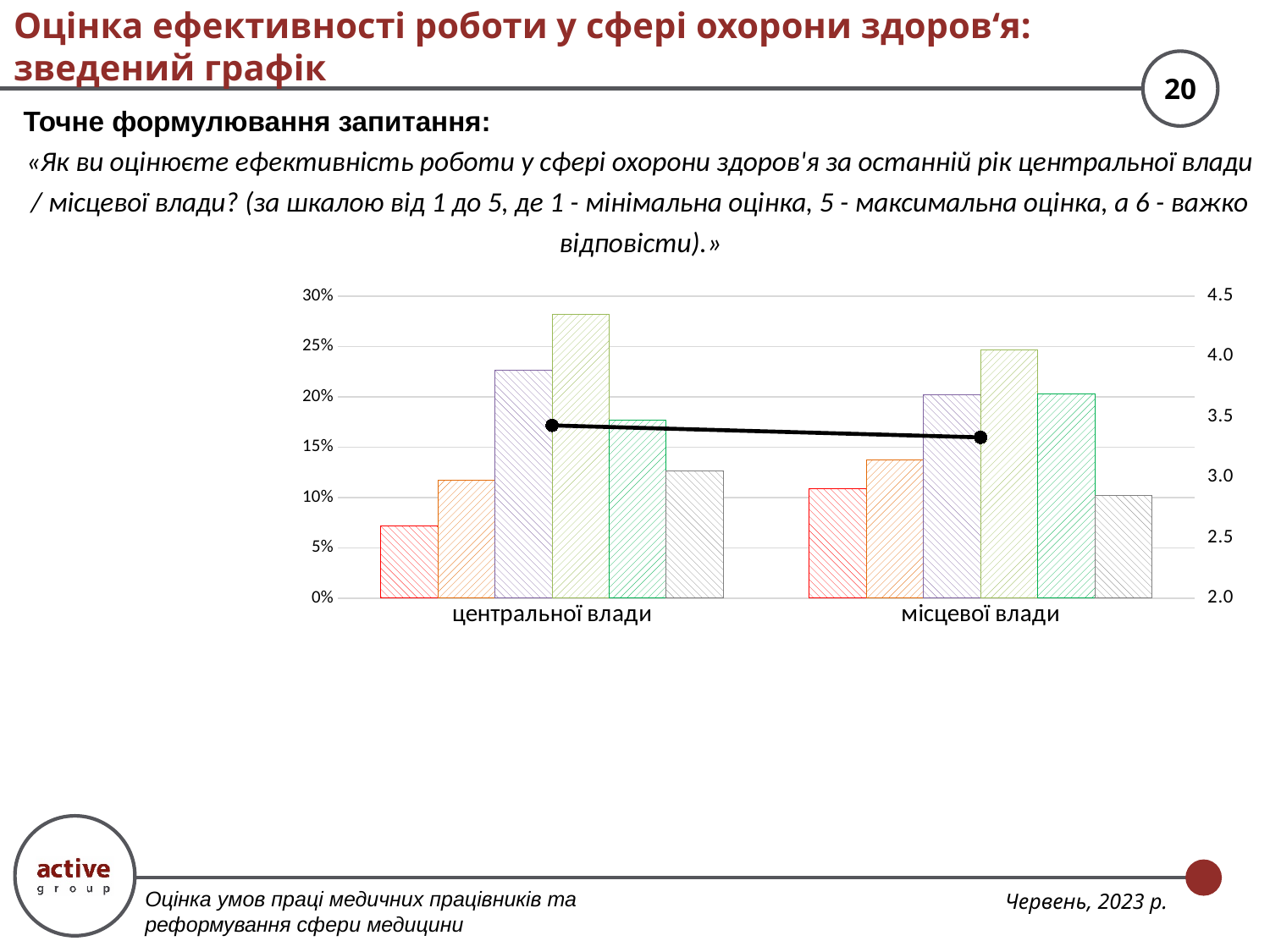
How many categories are shown on the x axis of the chart? 2 Is the shortest bar in the центральної влади group greater or less than 5%? greater Is the tallest bar in the місцевої влади group greater or less than 20%? greater What kind of chart is shown on the slide? Bar chart with a line Does the line plotted on the chart rise or fall from центральної влади to місцевої влади? Fall Is the line value for місцевої влади greater or less than 3.0 on the right axis? greater How many bars are plotted for each category in the chart? 6 For which category is the line value higher, центральної влади or місцевої влади? центральної влади What is the maximum value shown on the left vertical axis of the chart? 30% What are the two categories on the x axis of the chart? центральної влади, місцевої влади